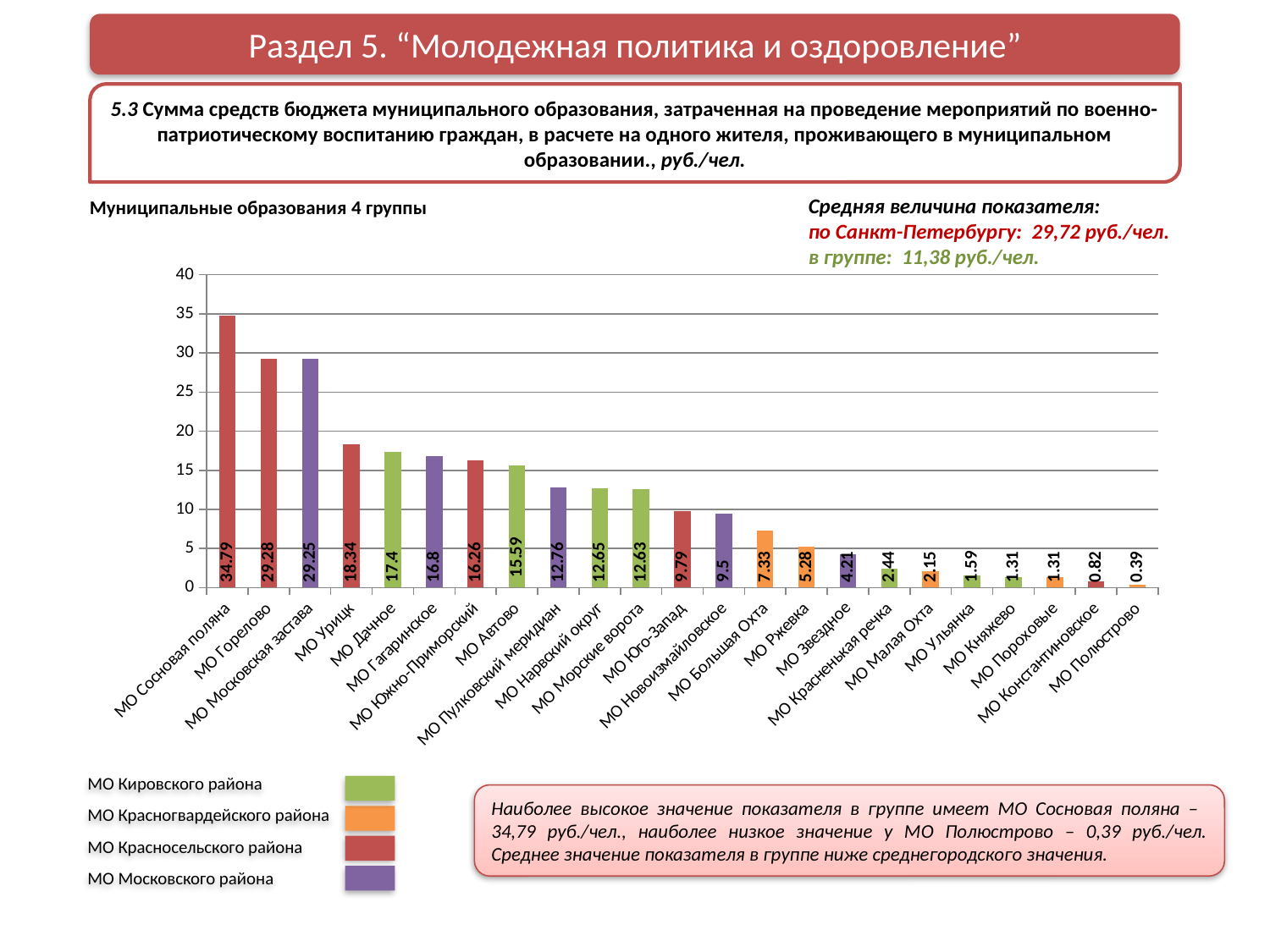
How many municipalities are shown on the chart? 23 Do the values rise or fall from left to right along the x axis? fall Which municipality has the lowest value on the chart? МО Полюстрово Which municipality has the highest value on the chart? МО Сосновая поляна Is the value for МО Московская застава greater or less than 25? greater What is the value for МО Сосновая поляна? 34.79 What is the value for МО Гагаринское? 16.8 Which is larger, the value for МО Автово or the value for МО Юго-Запад? МО Автово What kind of chart is shown on the slide? bar chart What is the value for МО Большая Охта? 7.33 What is the difference between the values for МО Урицк and МО Дачное? 0.94 How many district groups does the legend list? 4